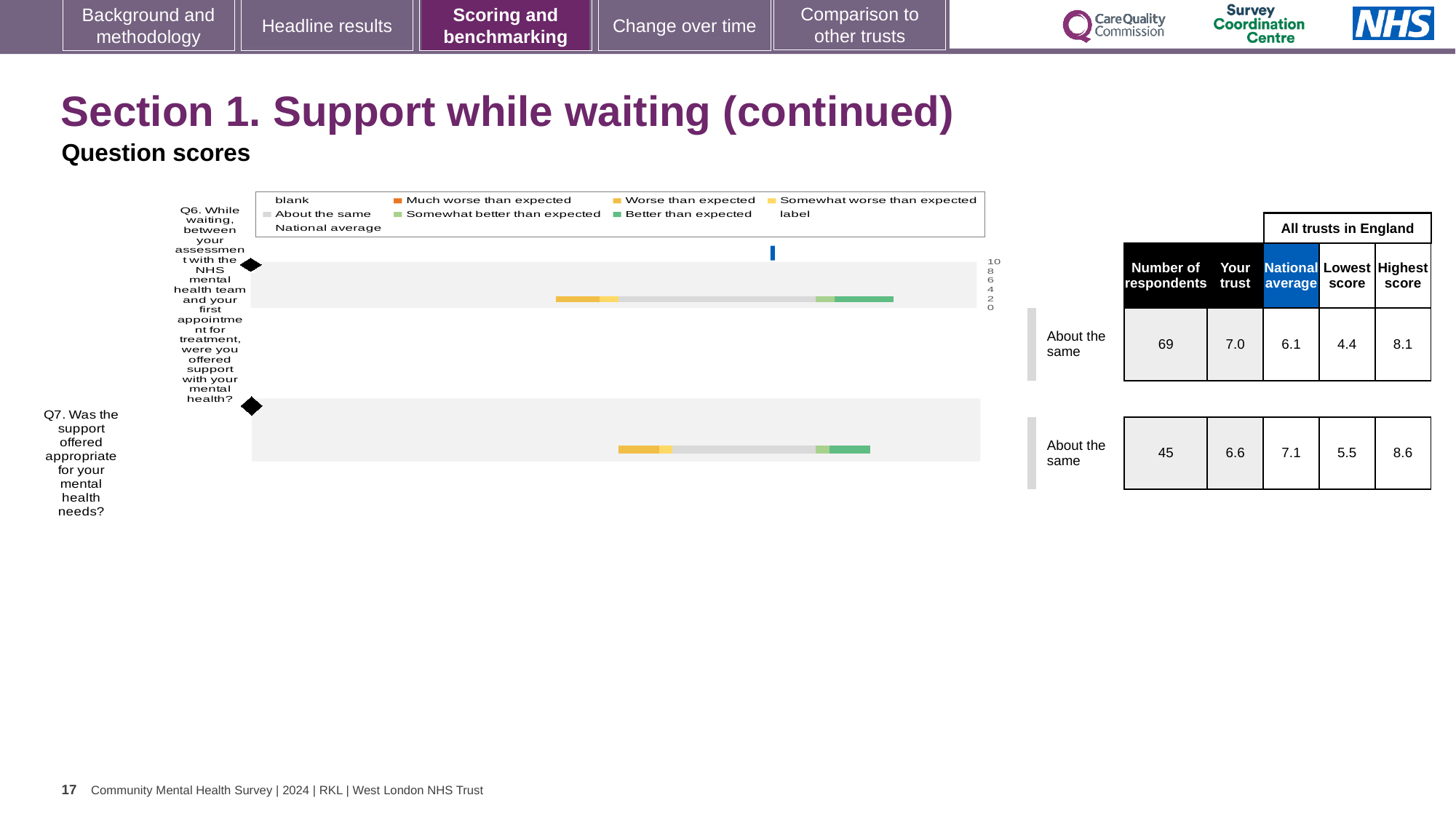
What kind of chart is used to show the question scores on this slide? bar chart For Q6, which is larger: the 'Your trust' score or the national average? Your trust What is the 'Your trust' score for Q6? 7.0 How many questions are plotted in the question scores chart? 2 What is the difference between the highest and lowest scores among all trusts in England for Q6? 3.7 What is the highest score among all trusts in England for Q7? 8.6 How many entries does the legend of the question scores chart list? 9 Which question has the greater number of respondents, Q6 or Q7? Q6 What is the national average score for Q6? 6.1 How many respondents answered Q7? 45 What benchmark category is shown for Q7? About the same For Q7, which is larger: the 'Your trust' score or the national average? National average